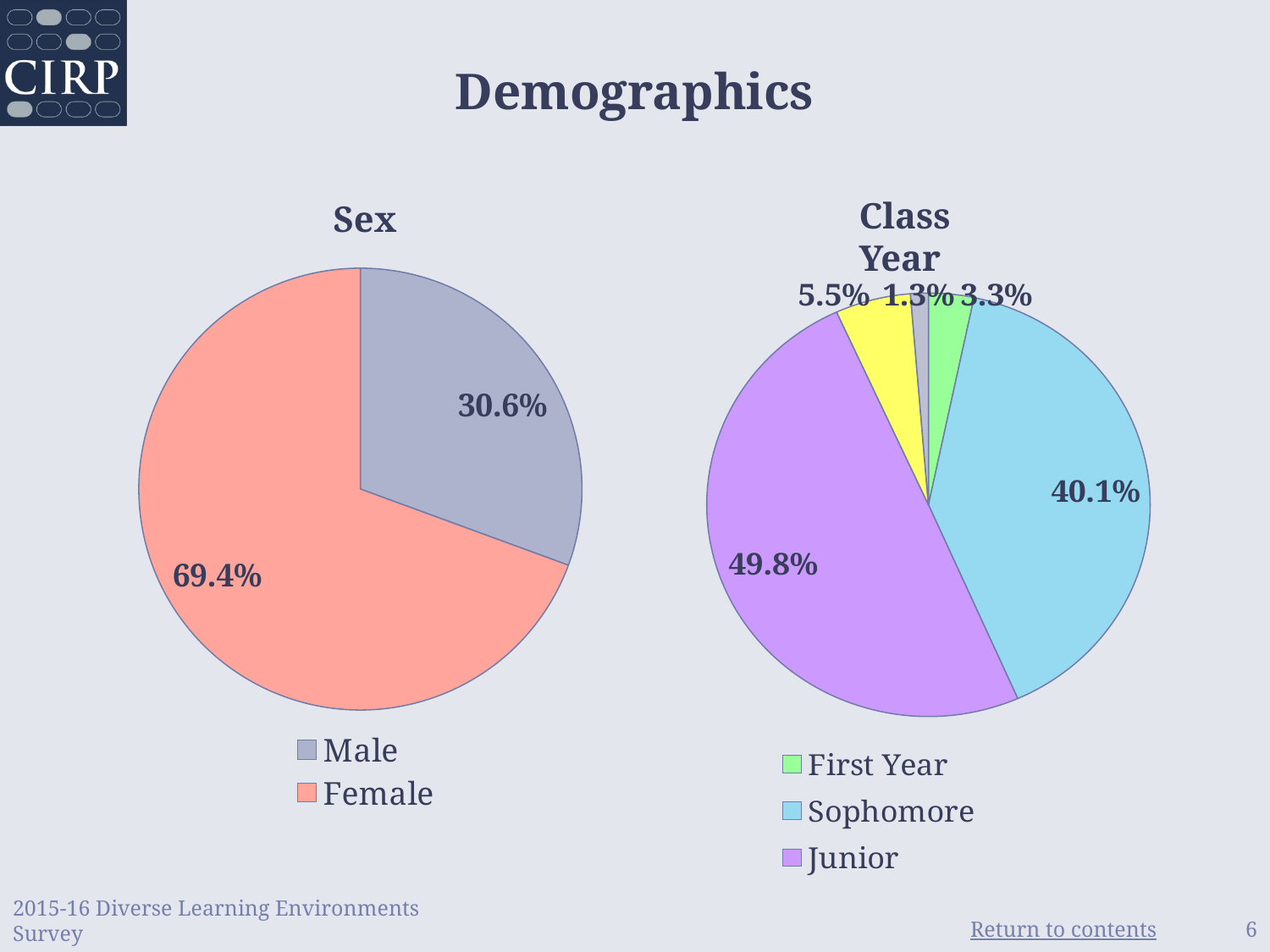
In the Sex chart, what is the difference in percentage points between Female and Male? 38.8 percentage points In the Class Year chart, which is larger, First Year or Sophomore? Sophomore What type of chart is the Sex chart? Pie chart In the Class Year chart, which labeled category has the largest share? Junior In the Class Year pie chart, what percentage is First Year? 3.3% In the Sex chart, which category has the larger share, Male or Female? Female In the Class Year chart, what is the difference in percentage points between Junior and Sophomore? 9.7 percentage points How many entries does the legend of the Class Year chart list? 3 In the Class Year pie chart, what percentage is Junior? 49.8% In the Sex pie chart, what percentage is Male? 30.6% In the Sex pie chart, what percentage is Female? 69.4% In the Class Year pie chart, what percentage is Sophomore? 40.1%